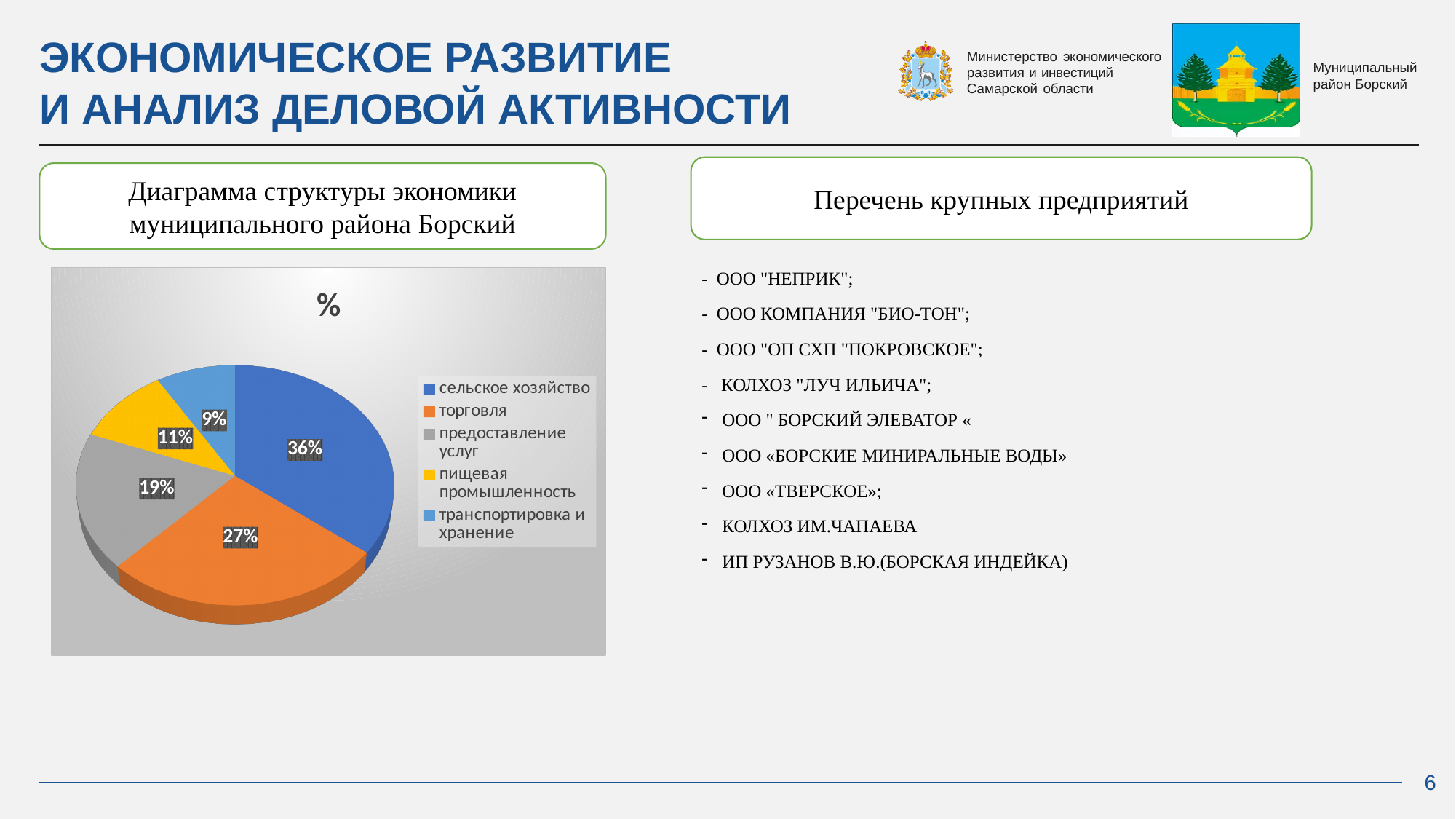
Which category has the smallest slice in the pie chart? транспортировка и хранение What value is shown for транспортировка и хранение in the pie chart? 9% Which category has the largest slice in the pie chart? сельское хозяйство What value is shown for предоставление услуг in the pie chart? 19% What value is shown for пищевая промышленность in the pie chart? 11% How many categories are shown in the pie chart? 5 What value is shown for торговля in the pie chart? 27% Which is larger, the share of предоставление услуг or пищевая промышленность? предоставление услуг What share of the pie chart does сельское хозяйство account for? 36% What kind of chart is shown on the slide? pie chart What is the difference between the shares of сельское хозяйство and торговля? 9% What is the title shown above the pie chart? %